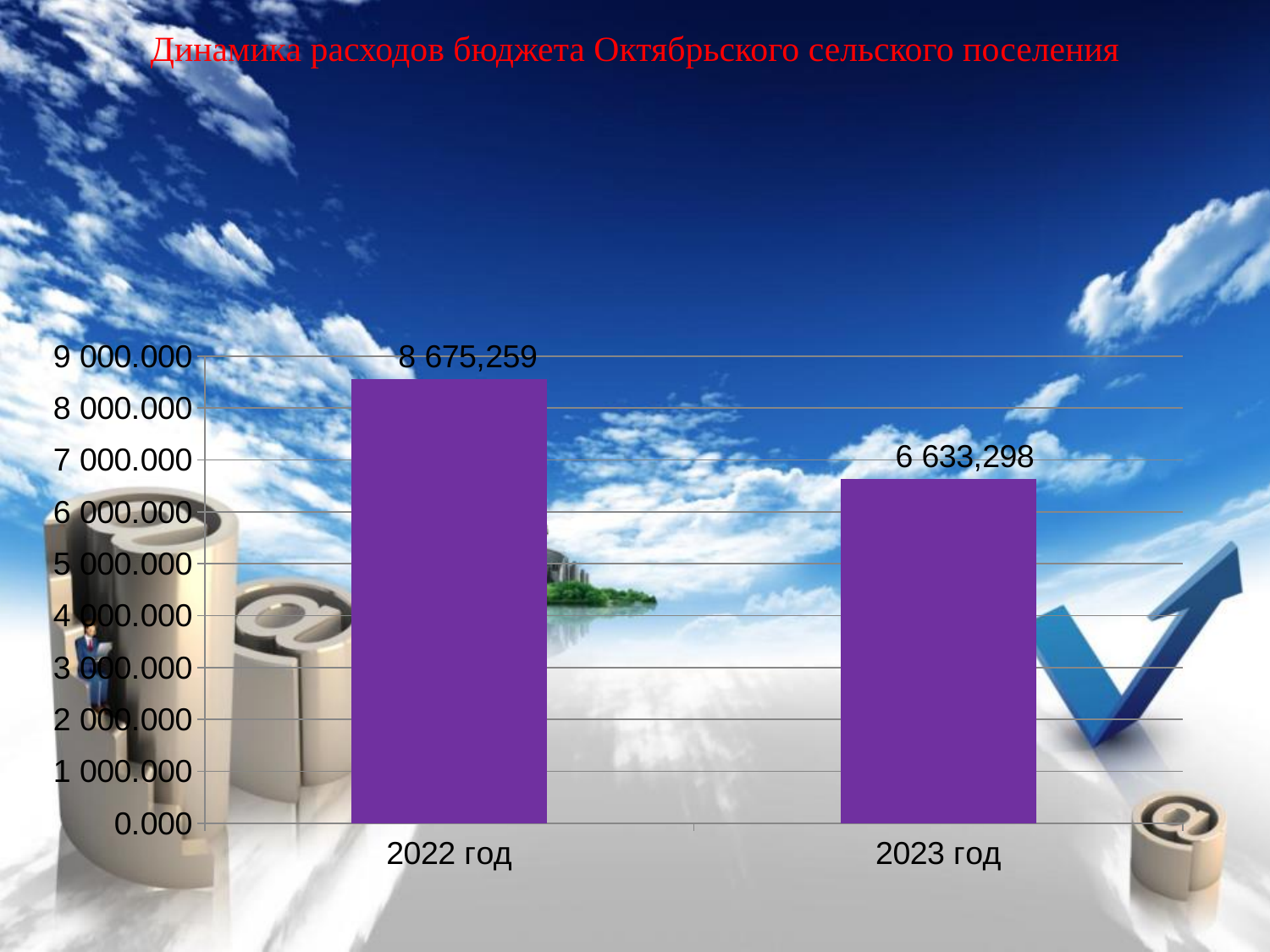
What is the value for 2023 год? 6 633,298 What is the value for 2022 год? 8 675,259 Do the values rise or fall from 2022 год to 2023 год? fall What is the title of the slide? Динамика расходов бюджета Октябрьского сельского поселения Is the value for 2023 год greater or less than 7 000.000? less Which year has the lowest value? 2023 год How many categories are shown on the x axis? 2 Which year has the highest value? 2022 год What is the difference between the values for 2022 год and 2023 год? 2 041,961 Which is larger, the value for 2022 год or the value for 2023 год? 2022 год What kind of chart is shown on the slide? bar chart Is the value for 2022 год greater or less than 8 000.000? greater